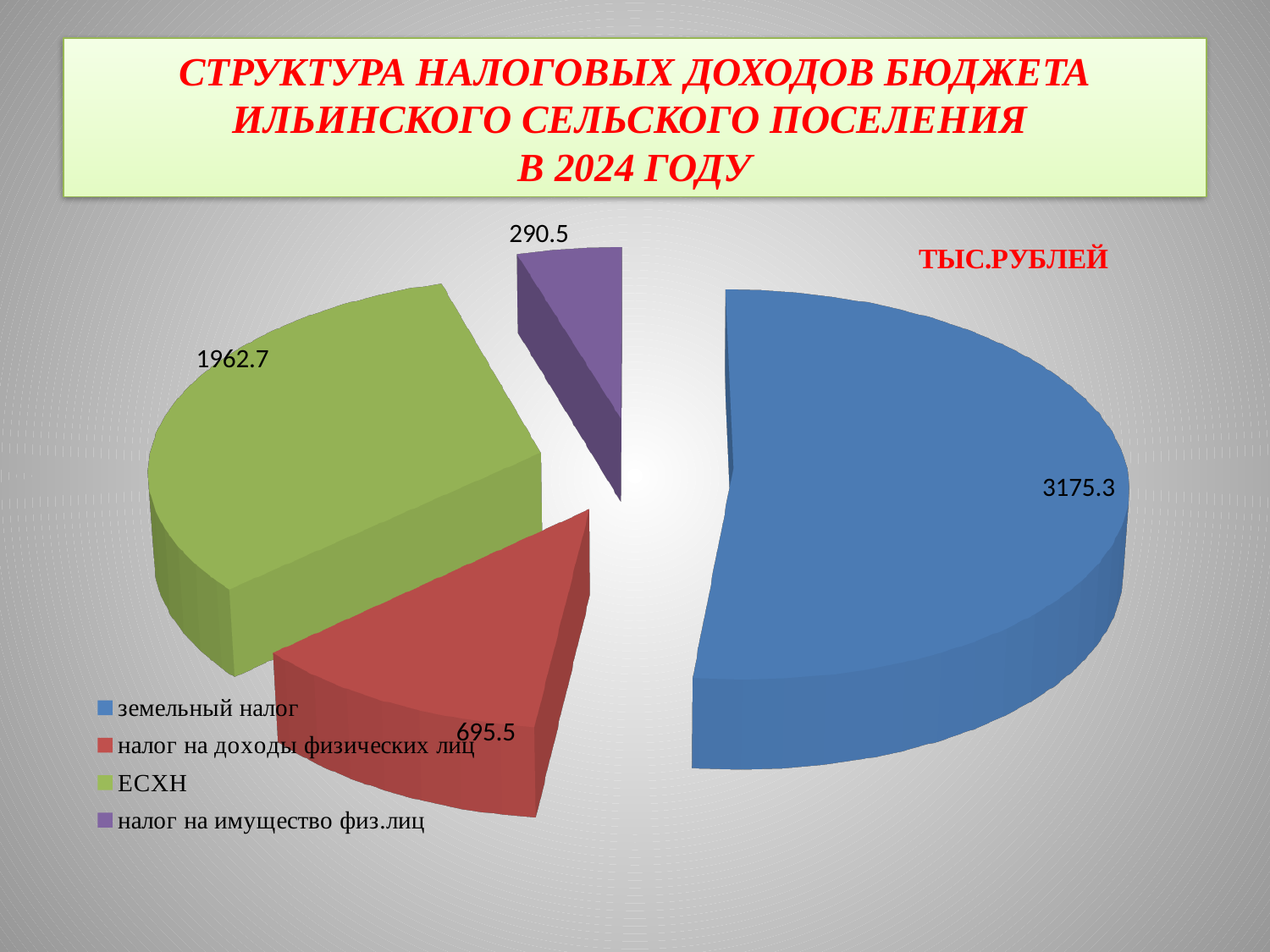
What is the value for налог на доходы физических лиц? 695.5 Which category has the largest value? земельный налог What unit is indicated for the values on the chart? ТЫС.РУБЛЕЙ What is the difference between земельный налог and ЕСХН? 1212.6 Which category has the smallest value? налог на имущество физ.лиц What is the value for налог на имущество физ.лиц? 290.5 What is the value for ЕСХН? 1962.7 How many slices does the pie chart have? 4 What kind of chart is shown on the slide? pie chart What is the value for земельный налог? 3175.3 Which is larger, ЕСХН or налог на доходы физических лиц? ЕСХН What is the difference between налог на доходы физических лиц and налог на имущество физ.лиц? 405.0